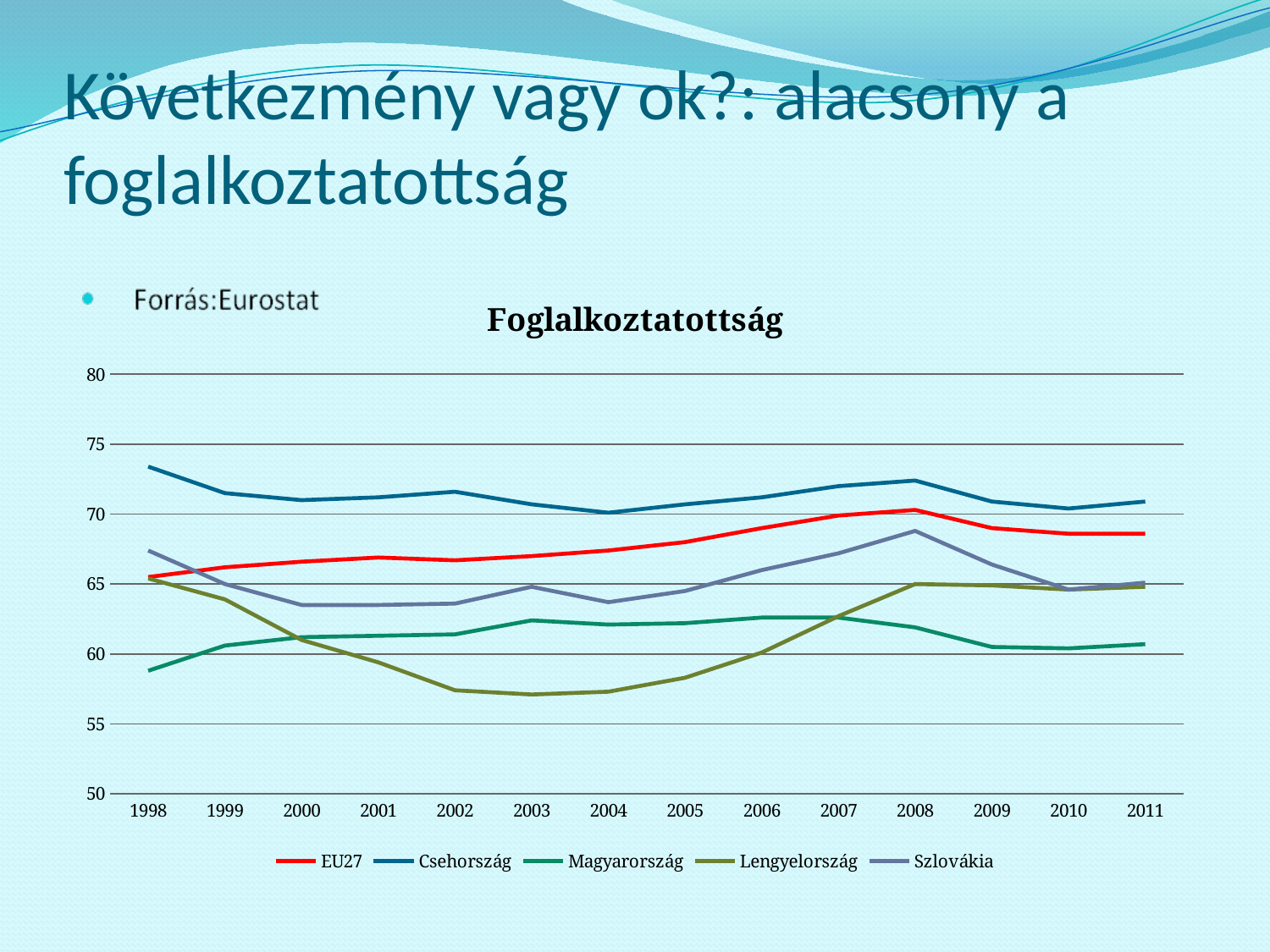
Is the value for Szlovákia in 2000 greater or less than 65? less In 2005, which is larger: the value for Csehország or the value for Magyarország? Csehország Is the value for Lengyelország in 2003 greater or less than 60? less What kind of chart is shown on the slide? line chart Is the value for Magyarország in 1998 greater or less than 60? less How many series does the legend list? 5 Which series has the lowest value in 2003? Lengyelország How many years are shown on the x axis? 14 Which series has the highest value in 2011? Csehország What is the title of the chart? Foglalkoztatottság Does the value for Lengyelország rise or fall from 1998 to 2002? fall